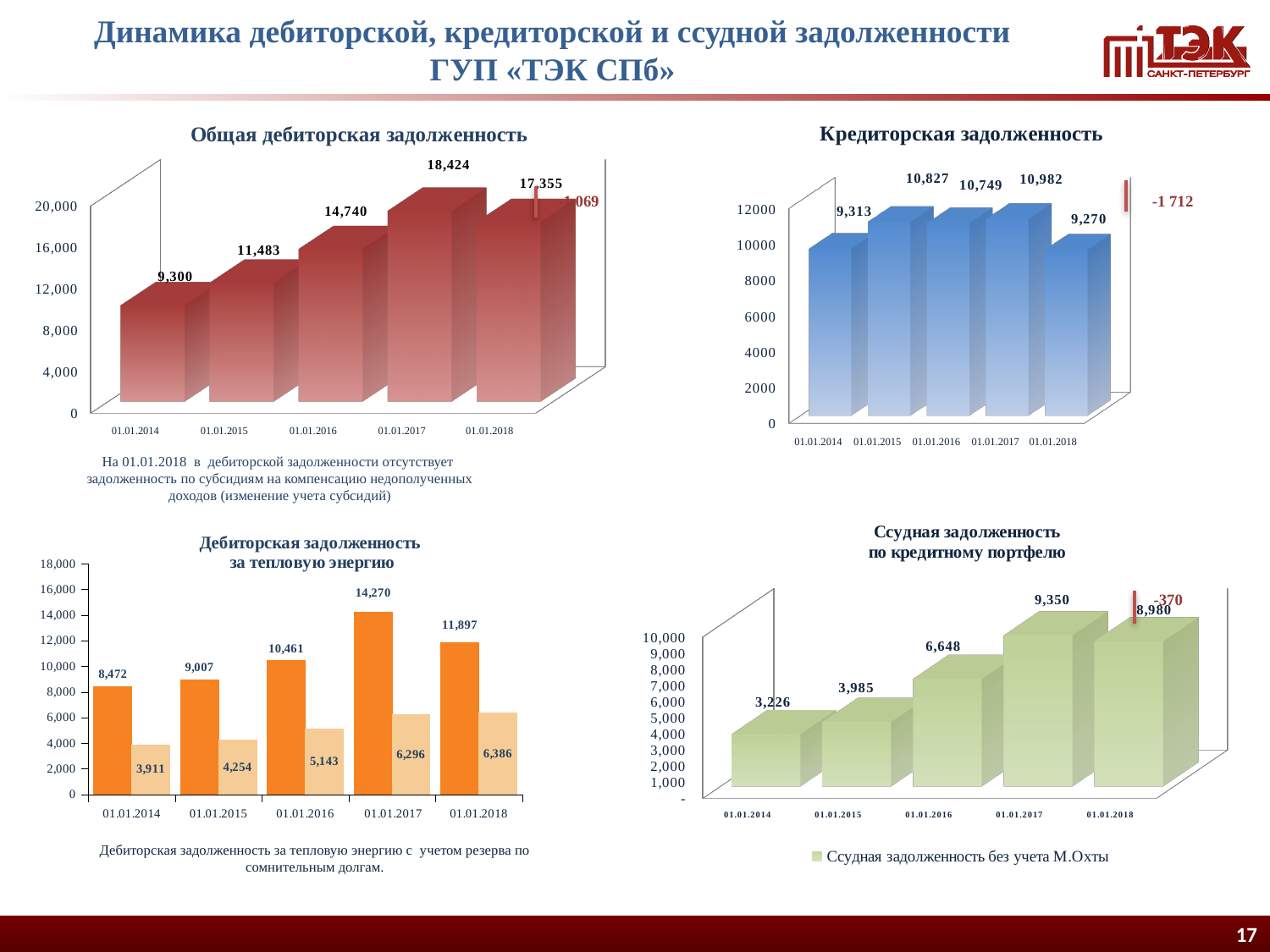
In the chart titled "Общая дебиторская задолженность", what is the difference between the values for 01.01.2017 and 01.01.2018? 1,069 In the chart titled "Кредиторская задолженность", what is the value for 01.01.2018? 9,270 In the chart titled "Дебиторская задолженность за тепловую энергию", what is the difference between the orange and light orange bars for 01.01.2014? 4,561 What kind of chart is the one titled "Ссудная задолженность по кредитному портфелю"? Bar chart In the chart titled "Ссудная задолженность по кредитному портфелю", what is the legend entry? Ссудная задолженность без учета М.Охты In the chart titled "Общая дебиторская задолженность", which date has the lowest value? 01.01.2014 In the chart titled "Дебиторская задолженность за тепловую энергию", which is larger: the orange bar for 01.01.2017 or the orange bar for 01.01.2018? 01.01.2017 In the chart titled "Кредиторская задолженность", which date has the highest value? 01.01.2017 In the chart titled "Кредиторская задолженность", how many dates are shown on the x axis? 5 In the chart titled "Дебиторская задолженность за тепловую энергию", what is the value of the light orange bar for 01.01.2016? 5,143 In the chart titled "Общая дебиторская задолженность", what is the value for 01.01.2017? 18,424 In the chart titled "Ссудная задолженность по кредитному портфелю", what is the value for 01.01.2016? 6,648